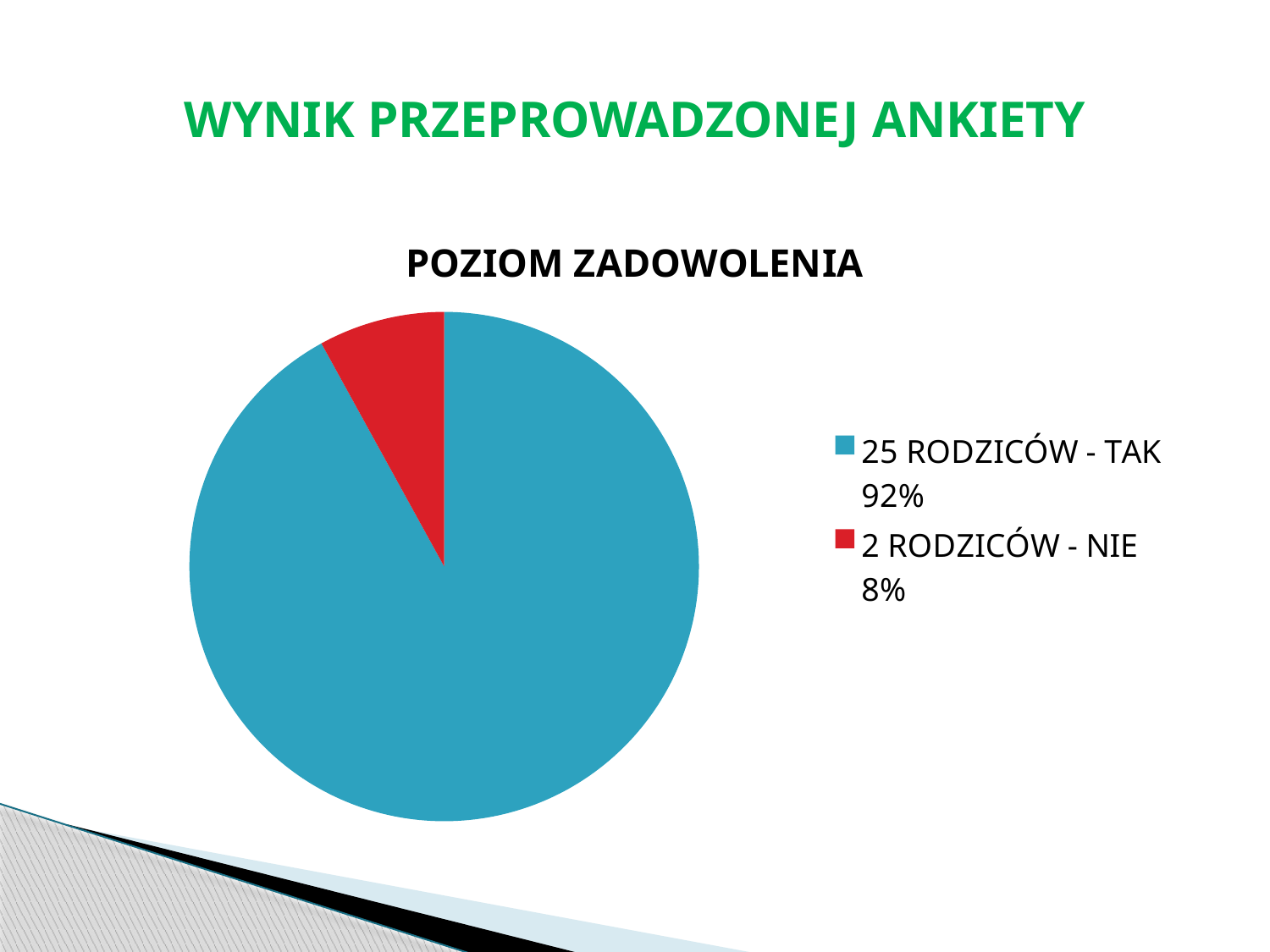
How many entries does the legend list? 2 What kind of chart is shown on the slide? pie chart What is the title of the chart? POZIOM ZADOWOLENIA What is the difference in percentage points between the 'TAK' and 'NIE' shares? 84 Which slice is the smallest? 2 RODZICÓW - NIE 8% Which slice is the largest? 25 RODZICÓW - TAK 92% What colour is the slice for 'NIE'? red How many parents answered 'NIE' according to the legend? 2 How many slices does the pie chart have? 2 What percentage share is shown for the 'NIE' (no) answer? 8% What percentage share is shown for the 'TAK' (yes) answer? 92% How many parents answered 'TAK' according to the legend? 25